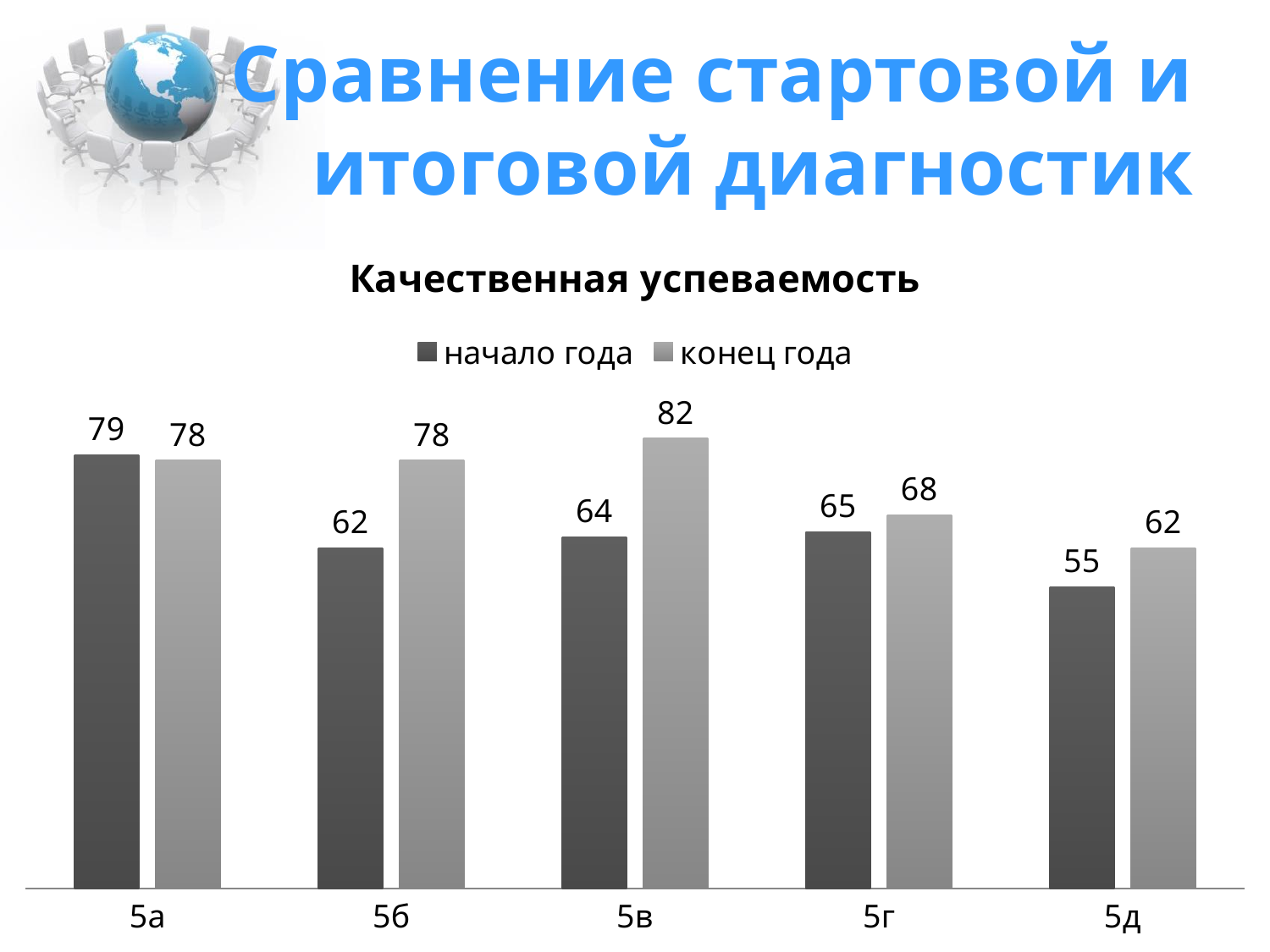
What is the value for 5в in the конец года series? 82 Which category has the lowest value in the начало года series? 5д Which is larger for 5а: the начало года value or the конец года value? начало года What is the value for 5а in the начало года series? 79 Which category has the highest value in the конец года series? 5в What kind of chart is shown on the slide? bar chart What is the difference between the конец года and начало года values for 5б? 16 How many categories are shown on the x axis? 5 What is the value for 5д in the начало года series? 55 How many series does the legend list? 2 What is the title of the chart? Качественная успеваемость What is the difference between the конец года and начало года values for 5в? 18